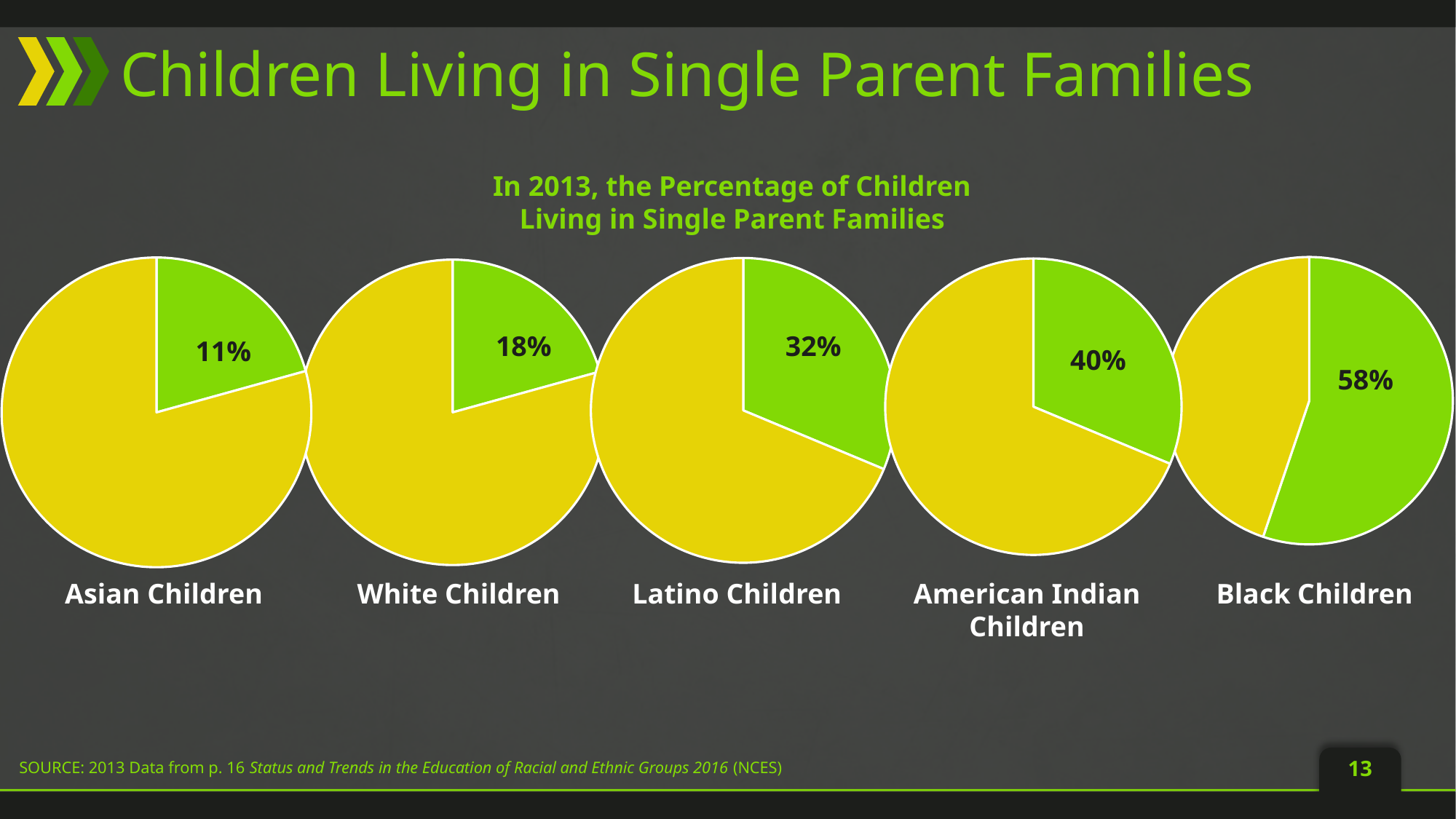
In the American Indian Children pie chart, what percentage is labelled on the green slice? 40% In the Black Children pie chart, what percentage of children live in single parent families? 58% Which is larger: the percentage in the Latino Children pie chart or the percentage in the White Children pie chart? Latino Children What is the title shown above the pie charts? In 2013, the Percentage of Children Living in Single Parent Families In the White Children pie chart, what percentage is shown for the green slice? 18% What kind of chart is used to show the percentage for each group of children? Pie chart What is the difference between the percentage shown in the Black Children pie chart and the percentage shown in the Asian Children pie chart? 47% In the Latino Children pie chart, what percentage of children live in single parent families? 32% Across the five pie charts, which group has the lowest percentage of children living in single parent families? Asian Children Across the five pie charts, which group has the highest percentage of children living in single parent families? Black Children How many pie charts are shown on the slide? 5 In the Asian Children pie chart, what percentage of children live in single parent families? 11%